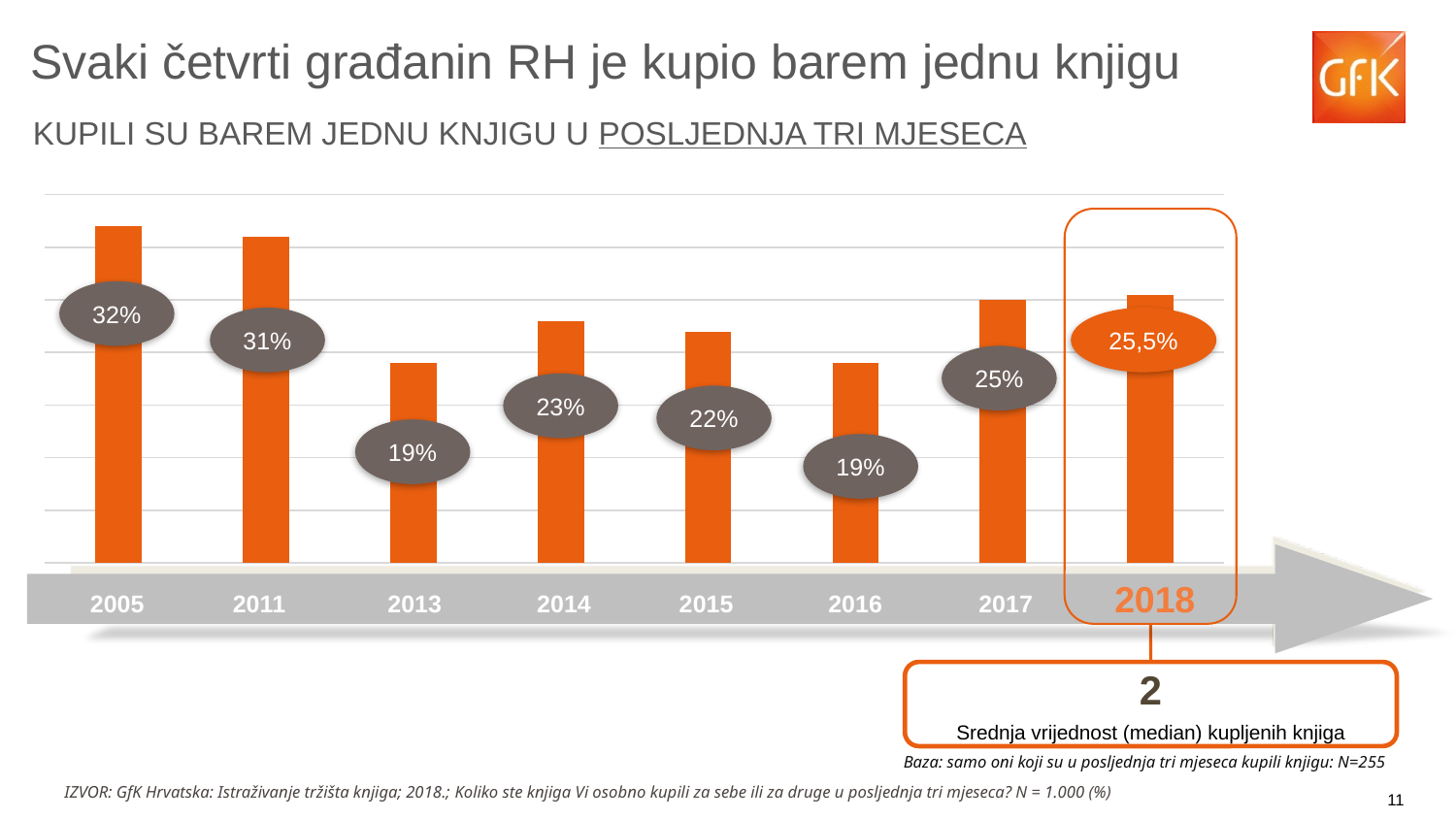
How many years are shown on the chart? 8 Which year has the larger value, 2014 or 2015? 2014 What percentage of citizens bought at least one book in the last three months in 2005? 32% What is the value shown for 2018? 25,5% What is the median number of books purchased, as shown in the box below the chart? 2 What is the value shown for 2014? 23% What kind of chart is shown on the slide? Bar chart What is the value shown for 2017? 25% What is the difference between the values for 2017 and 2016? 6% What is the lowest value shown on the chart? 19% What is the difference between the values for 2005 and 2011? 1% Which year has the highest value on the chart? 2005